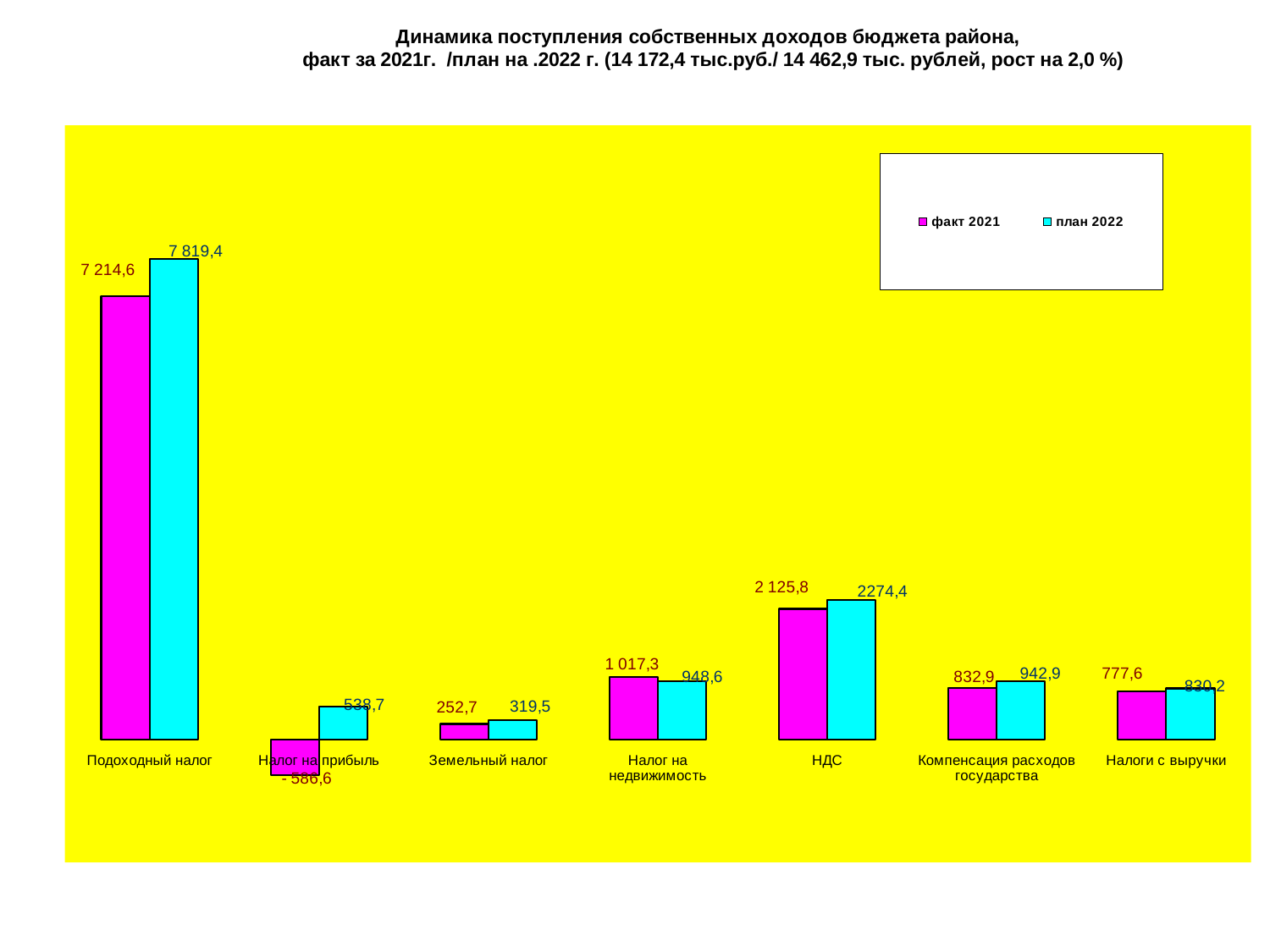
What is the план 2022 value for Земельный налог? 319,5 How many categories are shown on the x axis? 7 How many series does the legend list? 2 What is the факт 2021 value for Компенсация расходов государства? 832,9 What is the difference between the план 2022 and факт 2021 values for Подоходный налог? 604,8 Which category has the lowest факт 2021 value? Налог на прибыль For Налог на недвижимость, which is larger: the факт 2021 value or the план 2022 value? факт 2021 Which category has the highest план 2022 value? Подоходный налог What is the факт 2021 value for Налог на недвижимость? 1 017,3 What is the факт 2021 value for Подоходный налог? 7 214,6 What is the план 2022 value for НДС? 2274,4 What is the difference between the план 2022 and факт 2021 values for НДС? 148,6